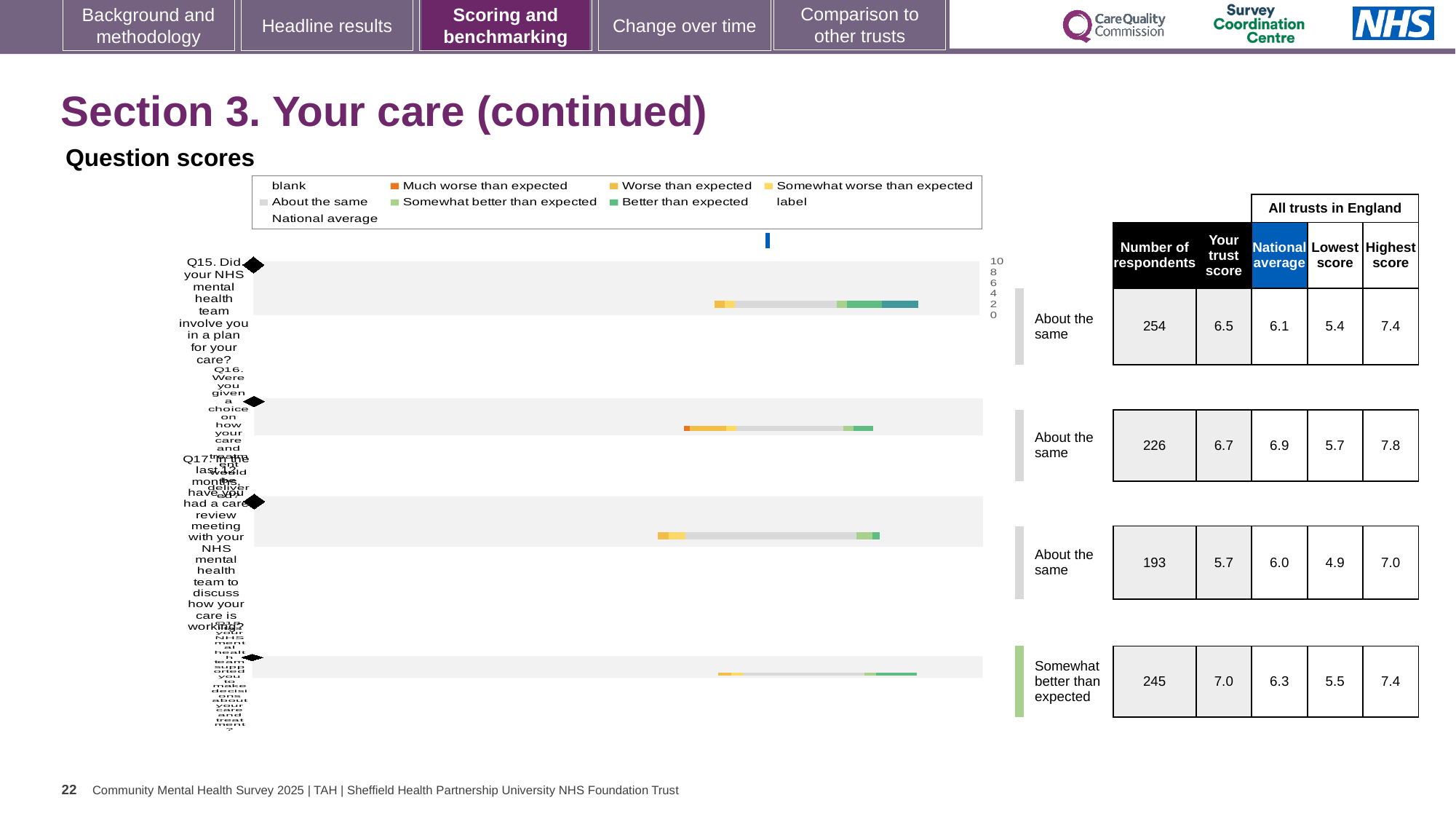
What is the national average for Q15? 6.1 For Q17, what is the difference between the highest score and the lowest score across all trusts in England? 2.1 What is the 'Your trust score' for Q15 (Did your NHS mental health team involve you in a plan for your care?)? 6.5 What benchmark category is shown for the fourth (bottom) question row? Somewhat better than expected What is the highest 'Your trust score' shown in the table on this slide? 7.0 What benchmark category is shown for Q15? About the same How many question rows are plotted in the question scores chart? 4 How many respondents are listed for Q15? 254 What kind of chart is used to show the question scores on this slide? bar chart What is the 'Your trust score' for Q17 (In the last 12 months, have you had a care review meeting)? 5.7 For Q15, which is larger: the trust score or the national average? Your trust score What is the lowest score among all trusts in England for Q17? 4.9